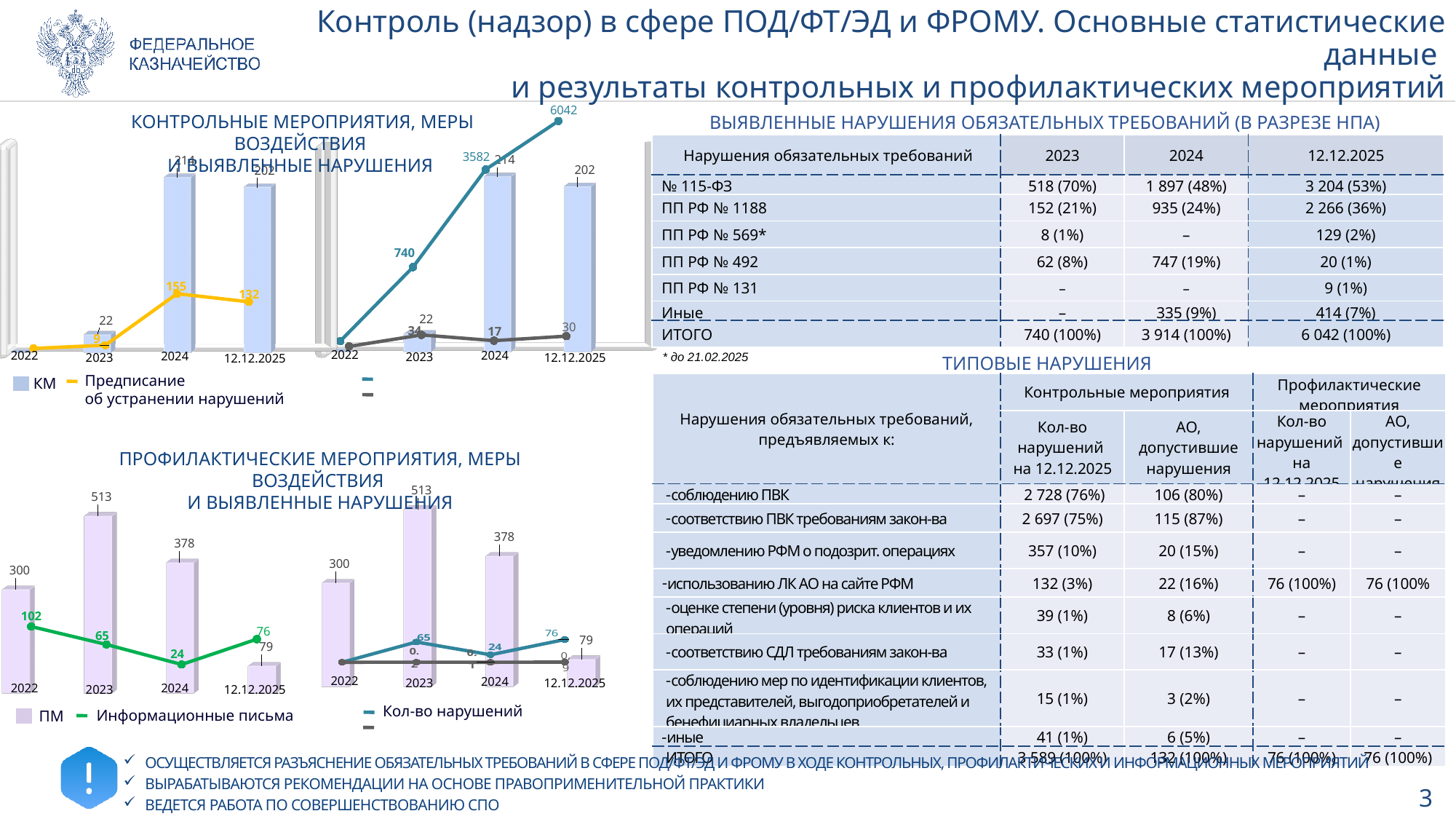
In the top-middle chart (the one whose teal line reaches 6042), what is the teal line's value for 2024? 3582 In the bottom-left chart (ПРОФИЛАКТИЧЕСКИЕ МЕРОПРИЯТИЯ...), what is the value of Информационные письма for 2022? 102 In the bottom-left chart (ПРОФИЛАКТИЧЕСКИЕ МЕРОПРИЯТИЯ, МЕРЫ ВОЗДЕЙСТВИЯ И ВЫЯВЛЕННЫЕ НАРУШЕНИЯ), what is the ПМ value for 2023? 513 In the bottom-left chart (ПРОФИЛАКТИЧЕСКИЕ МЕРОПРИЯТИЯ...), which is larger: Информационные письма for 2022 or for 12.12.2025? 2022 In the bottom-left chart (ПРОФИЛАКТИЧЕСКИЕ МЕРОПРИЯТИЯ...), what is the difference between the ПМ values for 2023 and 2024? 135 In the bottom-left chart (ПРОФИЛАКТИЧЕСКИЕ МЕРОПРИЯТИЯ...), which period has the lowest ПМ value? 12.12.2025 In the top-left chart (КОНТРОЛЬНЫЕ МЕРОПРИЯТИЯ, МЕРЫ ВОЗДЕЙСТВИЯ И ВЫЯВЛЕННЫЕ НАРУШЕНИЯ), what is the КМ value for 2024? 214 In the top-left chart (КОНТРОЛЬНЫЕ МЕРОПРИЯТИЯ...), what is the value of Предписание об устранении нарушений for 12.12.2025? 132 In the bottom-left chart (ПРОФИЛАКТИЧЕСКИЕ МЕРОПРИЯТИЯ...), how many series does the legend list? 2 In the top-left chart (КОНТРОЛЬНЫЕ МЕРОПРИЯТИЯ...), which period has the highest КМ value? 2024 In the top-middle chart (the one whose teal line reaches 6042), does the teal line rise or fall from 2022 to 12.12.2025? rises In the top-left chart (КОНТРОЛЬНЫЕ МЕРОПРИЯТИЯ...), what is the difference between the КМ values for 2024 and 12.12.2025? 12